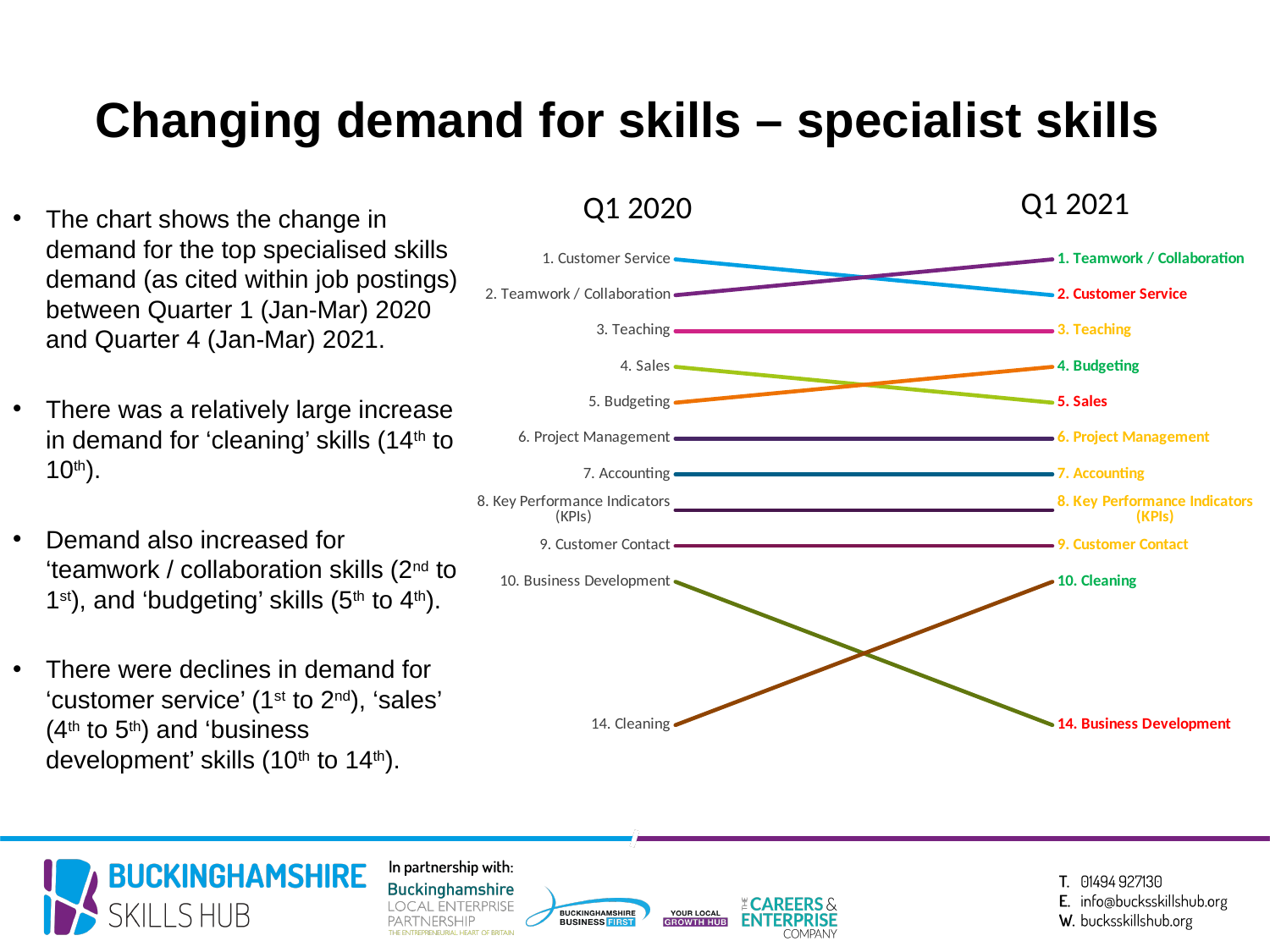
What rank did Cleaning hold in Q1 2020? 14 What rank did Business Development hold in Q1 2021? 14 What kind of chart is shown on the slide? Line chart (slope chart) What rank did Cleaning hold in Q1 2021? 10 Which skill was ranked 1st in Q1 2020? Customer Service By how many places did Cleaning's rank change between Q1 2020 and Q1 2021? 4 Which skill has the lowest rank (largest rank number) in Q1 2021? Business Development What rank did Budgeting hold in Q1 2020? 5 What are the two time periods compared in the chart? Q1 2020 and Q1 2021 Which skill was ranked 1st in Q1 2021? Teamwork / Collaboration Did the rank of Sales rise or fall from Q1 2020 to Q1 2021? Fall (4th to 5th) How many skills are plotted on the chart? 11